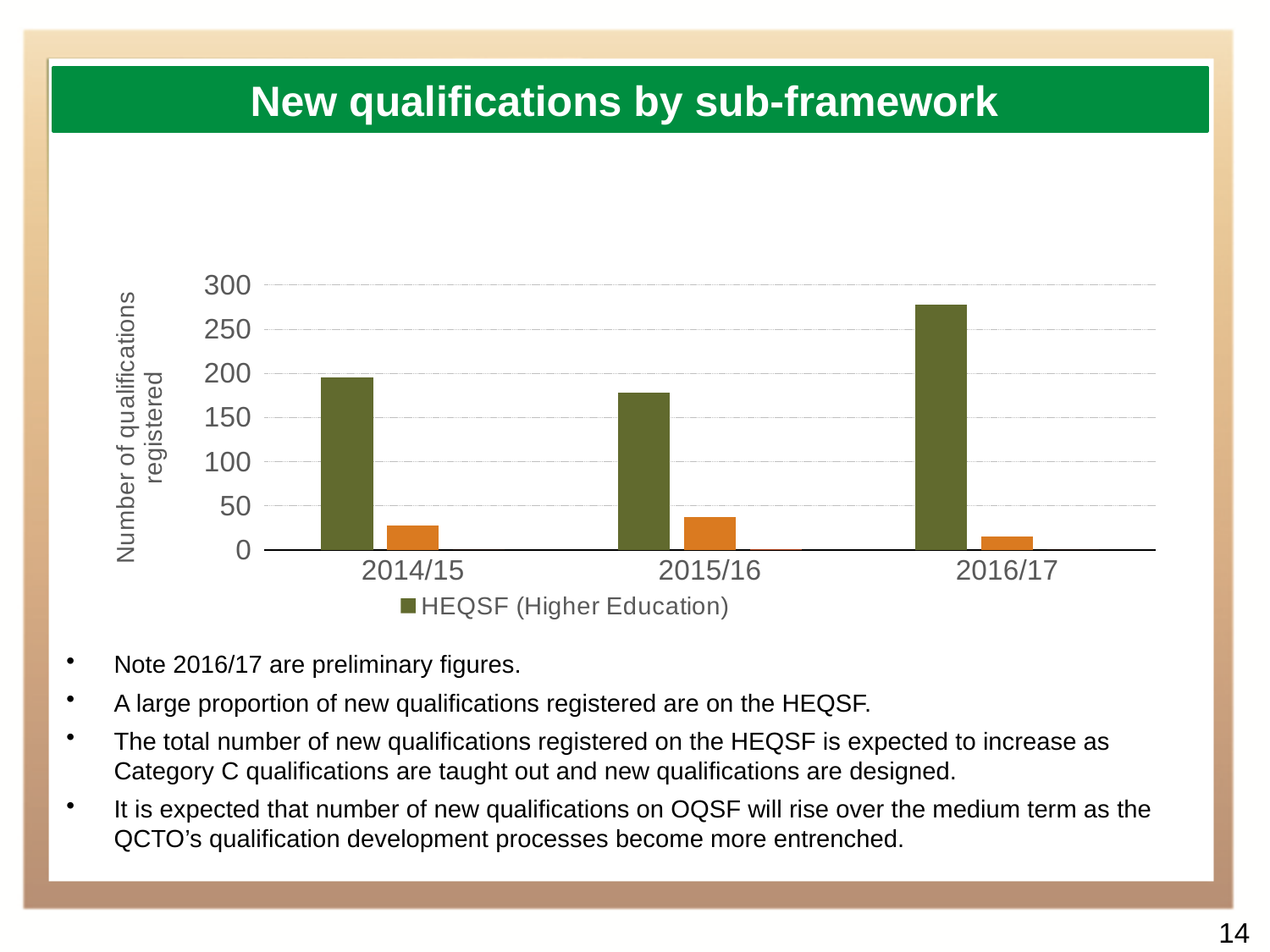
What is the label on the vertical axis of the chart? Number of qualifications registered Is the HEQSF (Higher Education) value for 2016/17 greater or less than 250? greater In which year is the HEQSF (Higher Education) value highest? 2016/17 In which year is the HEQSF (Higher Education) value lowest? 2015/16 What kind of chart is shown on the slide? bar chart Which is larger, the HEQSF (Higher Education) value for 2014/15 or for 2016/17? 2016/17 What is the title of the chart? New qualifications by sub-framework Is the HEQSF (Higher Education) value for 2014/15 greater or less than 150? greater Does the HEQSF (Higher Education) value rise or fall from 2015/16 to 2016/17? rise How many series does the legend list? 1 How many year categories are shown on the x axis? 3 Is the HEQSF (Higher Education) value for 2015/16 greater or less than 150? greater